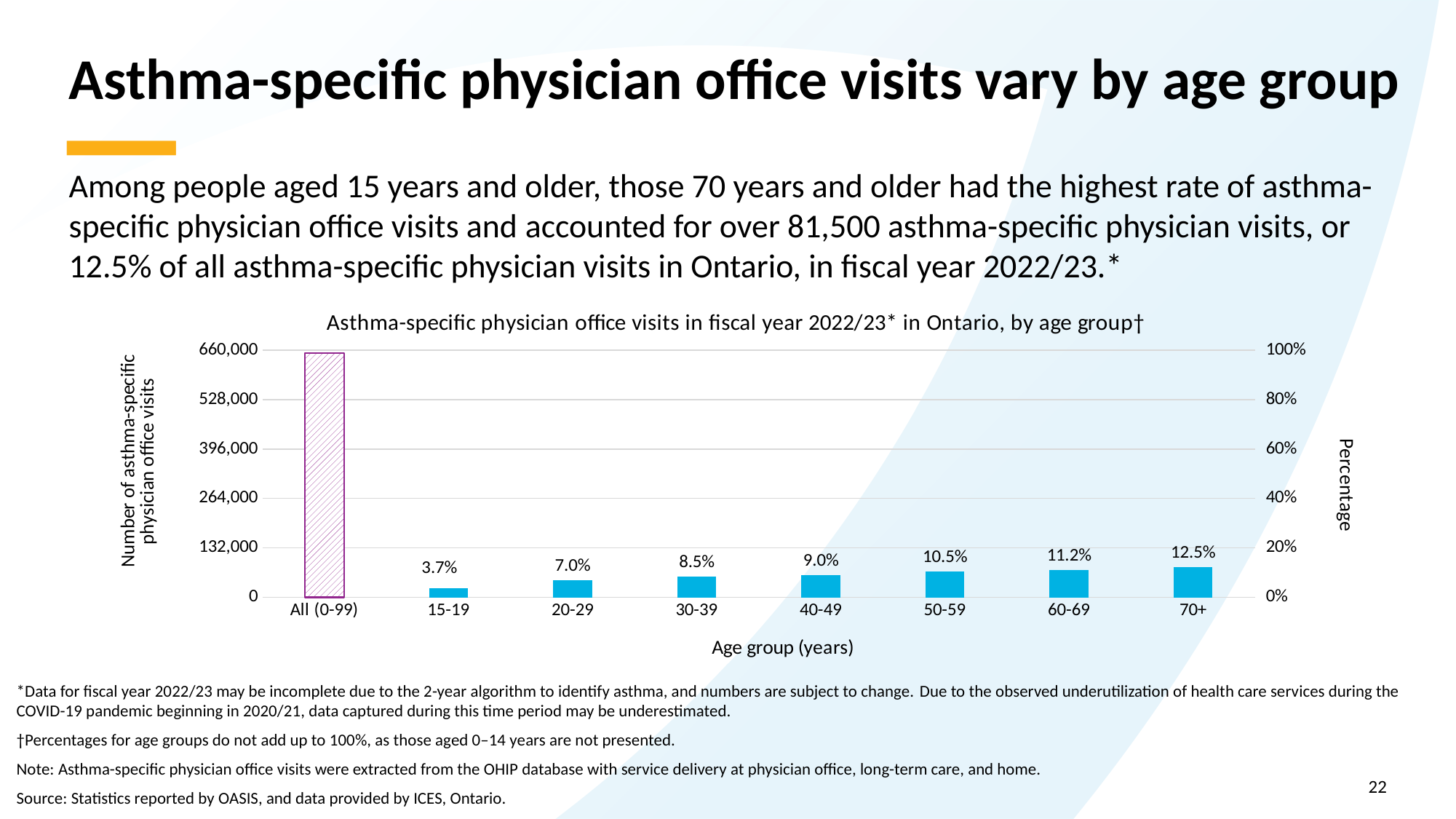
What type of chart is shown on the slide? bar chart What percentage is shown for the 40-49 age group? 9.0% How many age group categories are shown on the x axis? 8 What is the difference in percentage points between the 70+ and 15-19 age groups? 8.8 What percentage is shown for the 15-19 age group? 3.7% Which age group has a higher percentage, 50-59 or 30-39? 50-59 Among the age groups with percentage labels, which has the lowest percentage? 15-19 Among the age groups with percentage labels, which has the highest percentage? 70+ Do the percentages rise or fall as the age groups increase from 15-19 to 70+? rise What percentage of asthma-specific physician office visits is shown for the 70+ age group? 12.5% What is the label of the left vertical axis? Number of asthma-specific physician office visits Is the number of visits for the All (0-99) bar greater or less than 528,000? greater